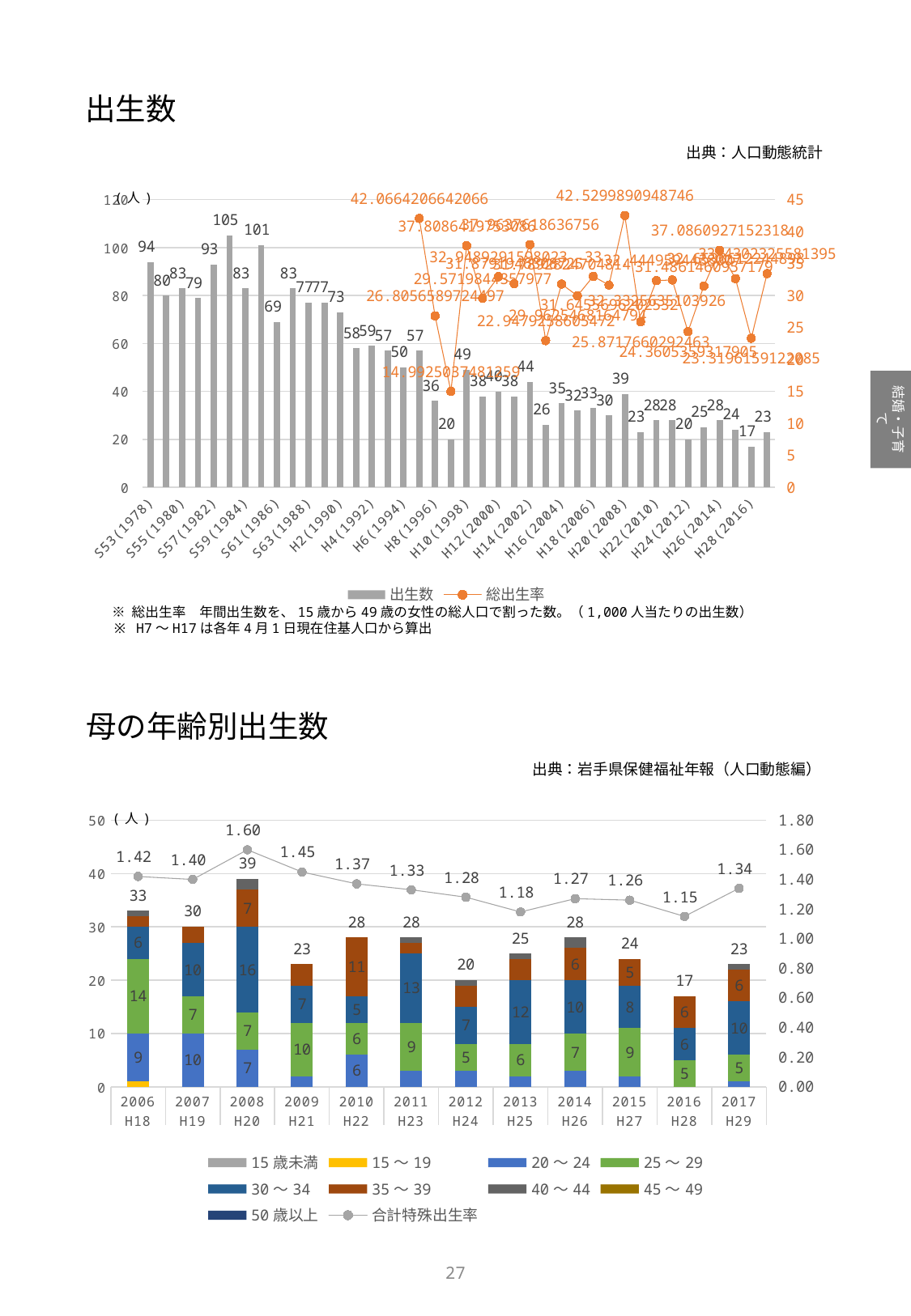
In the top chart (出生数), which labeled year has the lowest number of births? H28(2016) In the bottom chart (母の年齢別出生数), which year has the highest 合計特殊出生率? 2008 (H20) In the bottom chart (母の年齢別出生数), how many years are shown on the x axis? 12 In the bottom chart (母の年齢別出生数), what is the total number of births for 2008 (H20)? 39 In the top chart (出生数), how many series does the legend list? 2 In the bottom chart (母の年齢別出生数), what is the difference between the total births in 2006 (H18) and 2017 (H29)? 10 In the bottom chart (母の年齢別出生数), what is the 合計特殊出生率 value for 2016 (H28)? 1.15 In the top chart (出生数), do the bar values generally rise or fall from S53(1978) to H28(2016)? fall In the top chart (出生数), what is the number of births (出生数) for S53(1978)? 94 In the top chart (出生数), what is the number of births for H28(2016)? 17 In the bottom chart (母の年齢別出生数), what is the value of the 25～29 segment for 2006 (H18)? 14 In the top chart (出生数), what is the highest number of births shown by any bar? 105